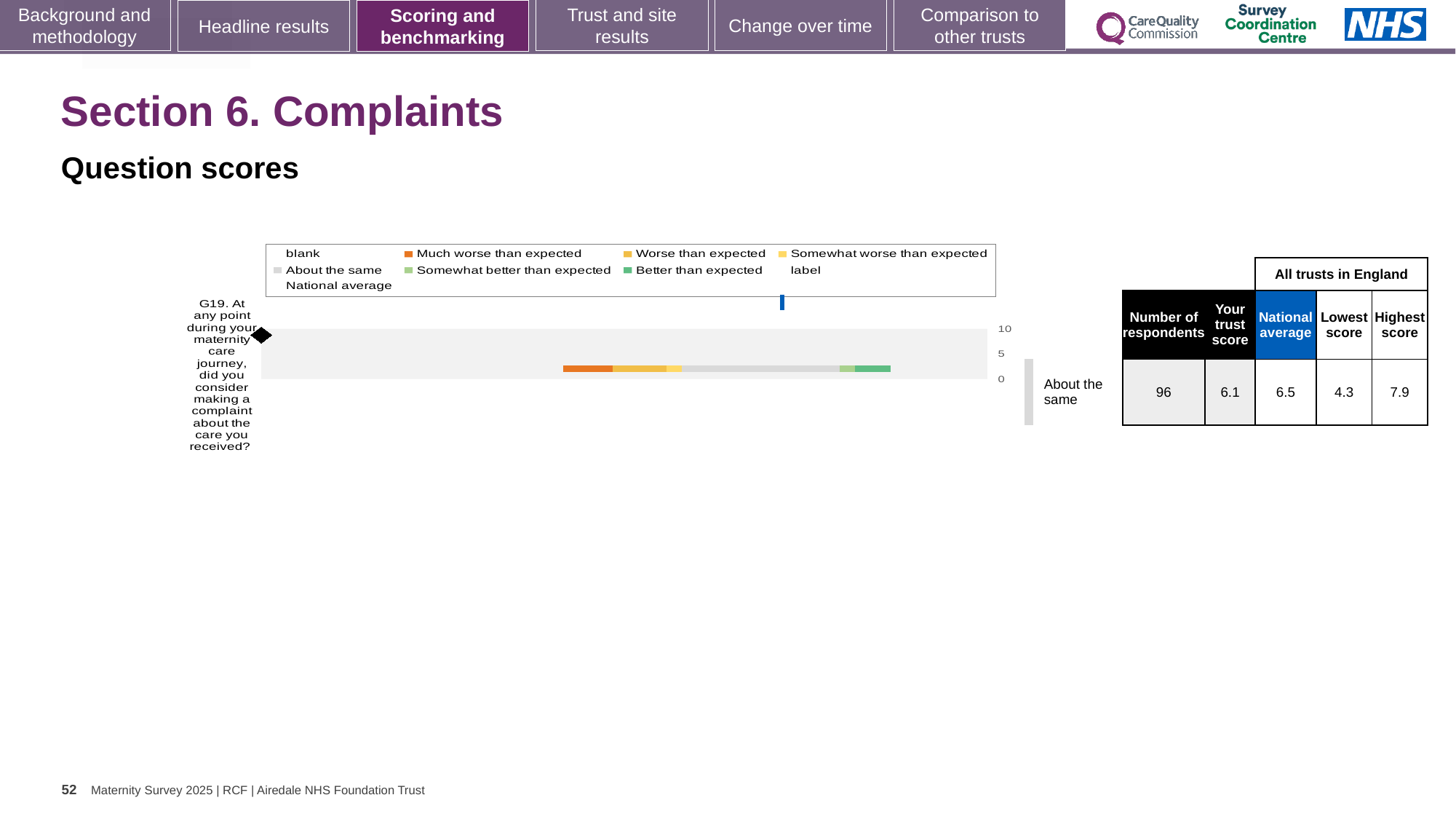
What is the lowest score among all trusts in England for question G19? 4.3 What is the highest score among all trusts in England for question G19? 7.9 Is the trust score for question G19 greater or less than 5? greater What kind of chart is shown on the slide for question G19? bar chart Which question is plotted in the chart? G19. At any point during your maternity care journey, did you consider making a complaint about the care you received? How many survey questions are plotted in the chart? 1 How many respondents answered question G19? 96 What is the trust score for question G19? 6.1 What is the national average score for question G19? 6.5 Which is larger for question G19, the trust score or the national average? national average According to the legend, what does the blue marker on the chart represent? National average What is the difference between the national average and the trust score for question G19? 0.4